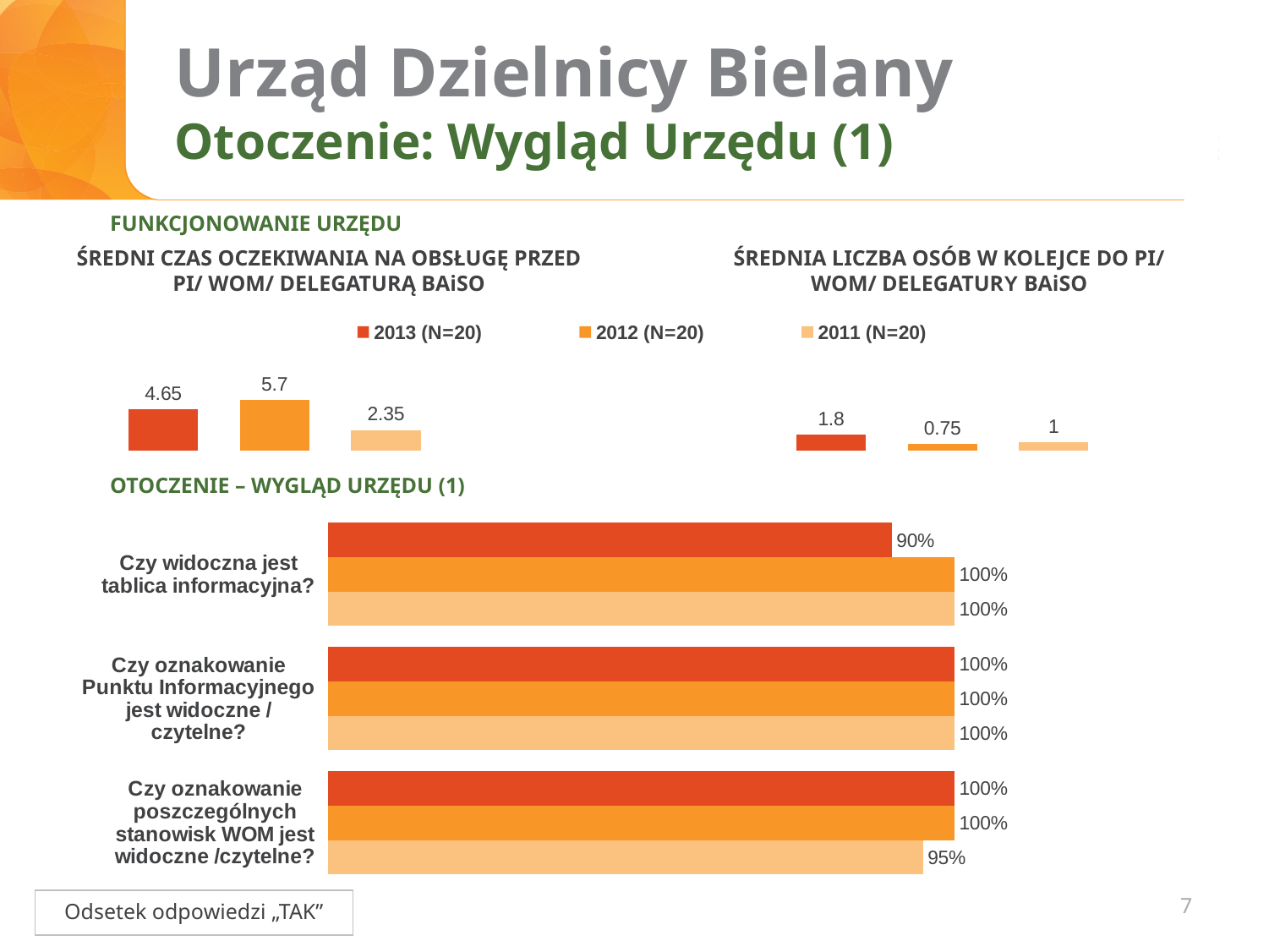
In the chart 'OTOCZENIE – WYGLĄD URZĘDU (1)', what is the 2011 value for 'Czy oznakowanie poszczególnych stanowisk WOM jest widoczne /czytelne?'? 95% In the chart 'ŚREDNIA LICZBA OSÓB W KOLEJCE DO PI/ WOM/ DELEGATURY BAiSO', what is the value for 2012 (N=20)? 0.75 In the chart 'ŚREDNI CZAS OCZEKIWANIA NA OBSŁUGĘ PRZED PI/ WOM/ DELEGATURĄ BAiSO', what is the difference between the 2012 and 2011 values? 3.35 In the chart 'OTOCZENIE – WYGLĄD URZĘDU (1)', what is the 2013 value for 'Czy widoczna jest tablica informacyjna?'? 90% In the chart 'ŚREDNIA LICZBA OSÓB W KOLEJCE DO PI/ WOM/ DELEGATURY BAiSO', is the value for 2013 larger or smaller than the value for 2011? larger In the chart 'OTOCZENIE – WYGLĄD URZĘDU (1)', what is the difference between the 2012 and 2013 values for 'Czy widoczna jest tablica informacyjna?'? 10% In the chart 'ŚREDNI CZAS OCZEKIWANIA NA OBSŁUGĘ PRZED PI/ WOM/ DELEGATURĄ BAiSO', what is the value for 2013 (N=20)? 4.65 In the chart 'ŚREDNI CZAS OCZEKIWANIA NA OBSŁUGĘ PRZED PI/ WOM/ DELEGATURĄ BAiSO', which year has the highest value? 2012 (N=20) How many series does the legend list for the charts on this slide? 3 In the chart 'OTOCZENIE – WYGLĄD URZĘDU (1)', how many question categories are shown? 3 What type of chart is 'OTOCZENIE – WYGLĄD URZĘDU (1)'? bar chart In the chart 'ŚREDNIA LICZBA OSÓB W KOLEJCE DO PI/ WOM/ DELEGATURY BAiSO', which year has the lowest value? 2012 (N=20)